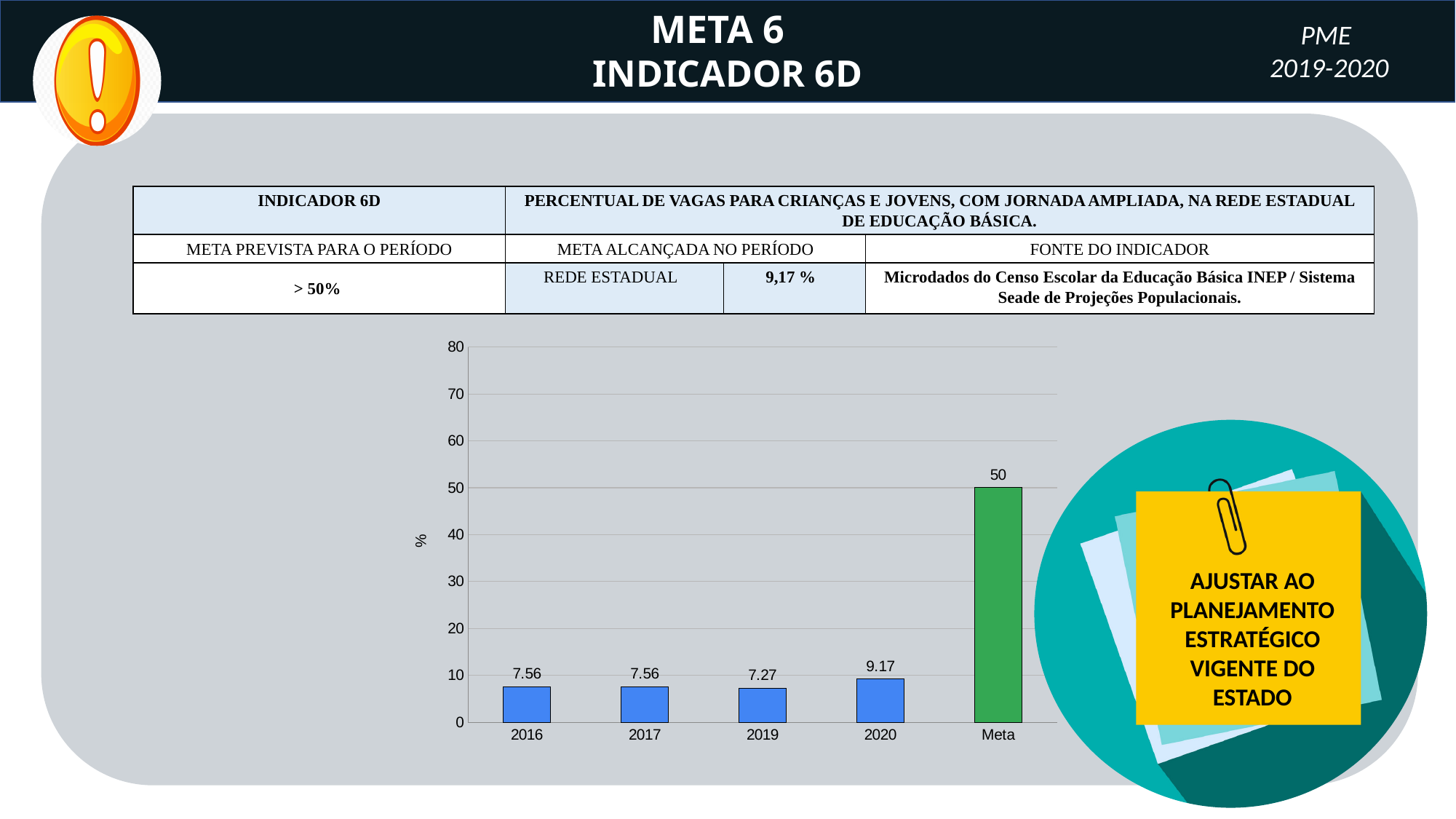
Which category has the highest value? Meta How many categories are shown on the x axis? 5 What kind of chart is shown on the slide? bar chart What is the difference between the 2020 value and the 2019 value? 1.9 Which is larger, the value for 2020 or the value for 2017? 2020 What is the difference between the Meta value and the 2020 value? 40.83 What is the value for Meta? 50 What is the value for 2020? 9.17 What is the value for 2019? 7.27 Is the value for Meta greater or less than 40? greater What is the value for 2016? 7.56 Which category has the lowest value? 2019